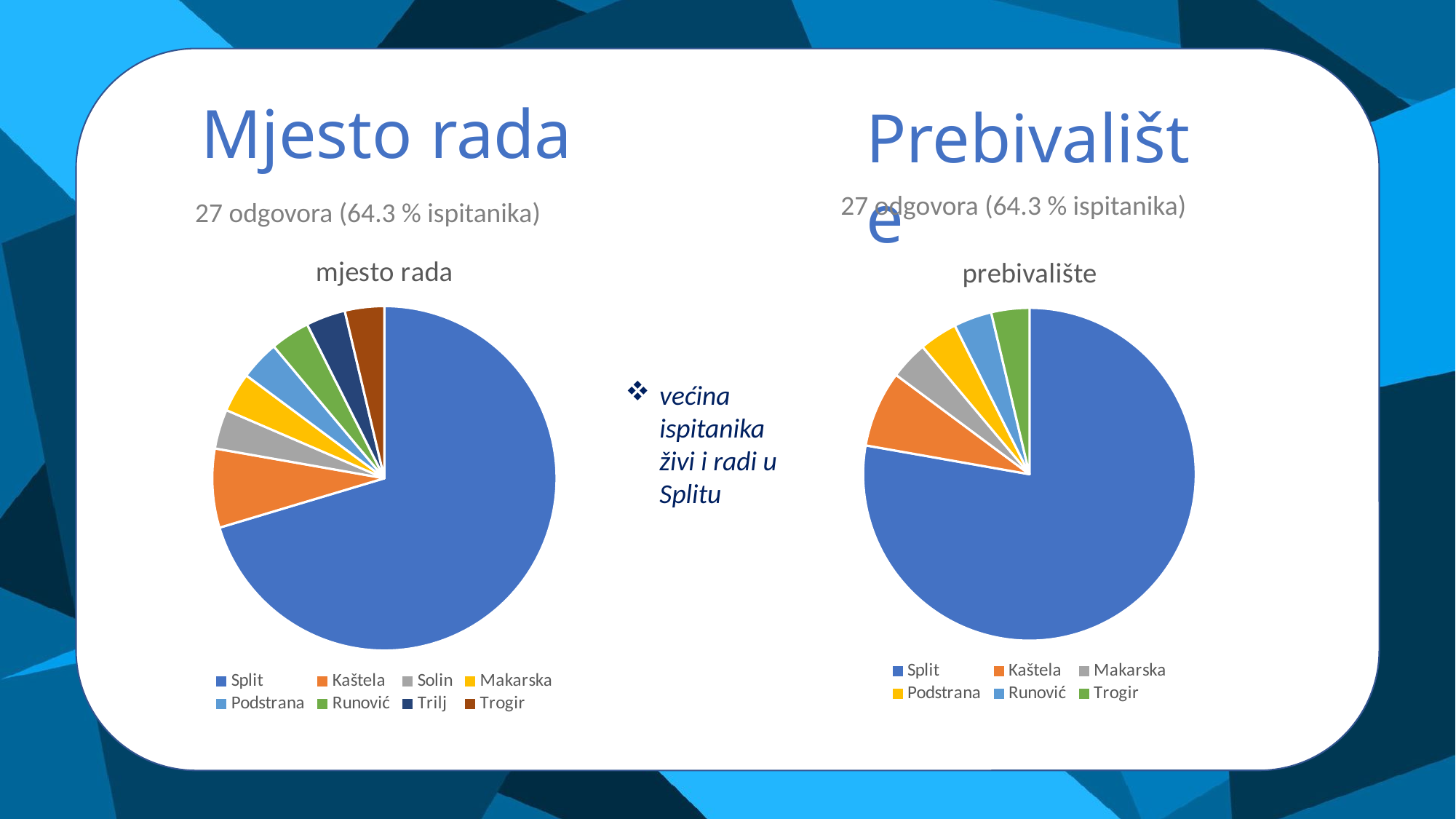
In the "prebivalište" chart, how many categories does the legend list? 6 In the "prebivalište" chart, which category has the largest slice? Split In the "prebivalište" chart, which slice is larger, Split or Kaštela? Split In the "mjesto rada" chart, which category has the largest slice? Split In the "prebivalište" chart, which slice is larger, Kaštela or Makarska? Kaštela In the "mjesto rada" chart, which slice is larger, Kaštela or Solin? Kaštela What is the title of the pie chart on the left? mjesto rada What kind of chart is the "prebivalište" chart on the right? pie chart What kind of chart is the "mjesto rada" chart on the left? pie chart Which category appears in the legend of the "mjesto rada" chart but not in the legend of the "prebivalište" chart, besides Solin? Trilj In the "mjesto rada" chart, how many categories does the legend list? 8